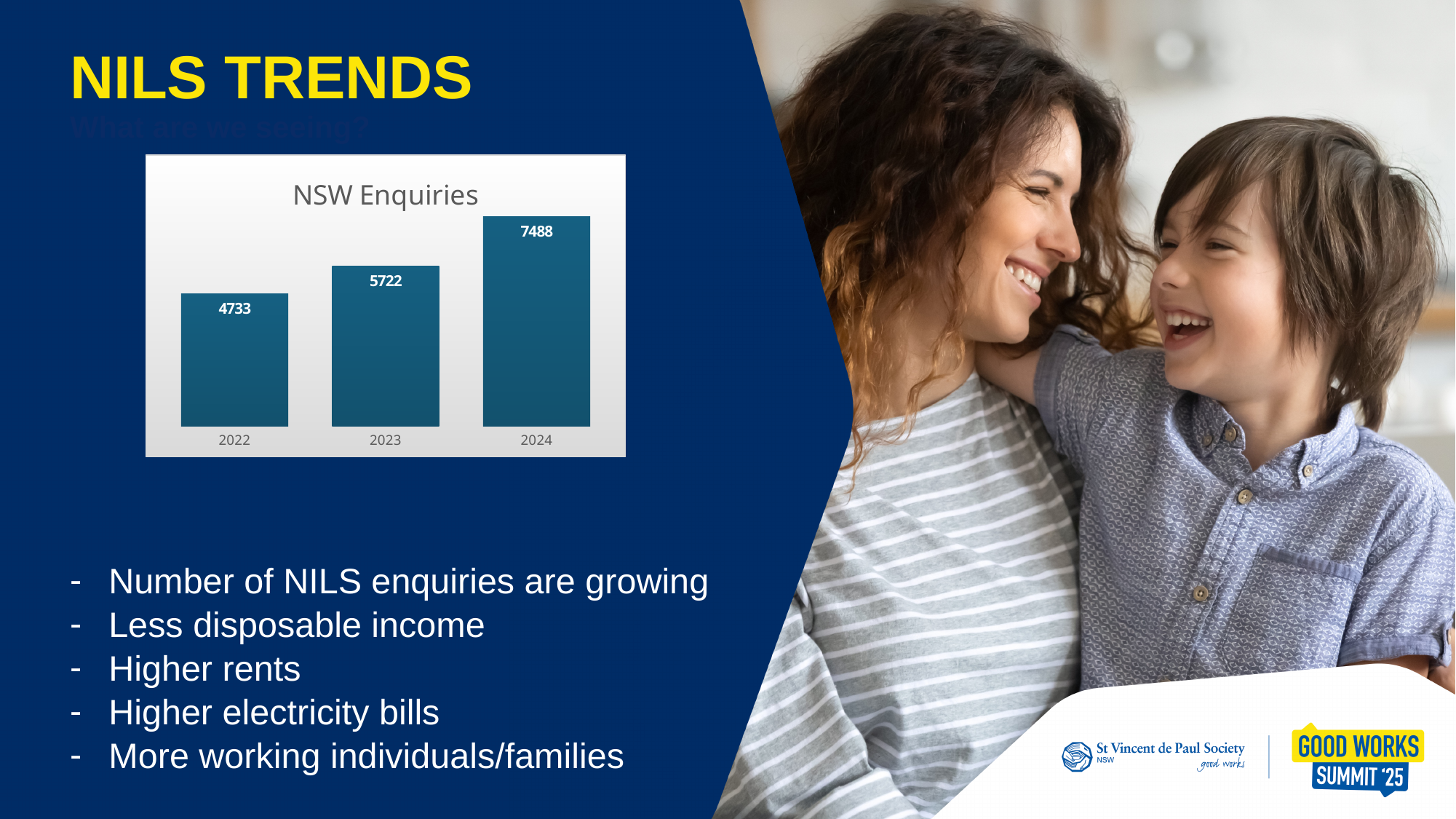
Which year has the highest number of NSW enquiries? 2024 What is the value for 2022 in the NSW Enquiries chart? 4733 Which is larger in the NSW Enquiries chart, the value for 2023 or the value for 2024? 2024 What is the difference between the 2023 and 2022 values in the NSW Enquiries chart? 989 How many years are shown in the NSW Enquiries chart? 3 What kind of chart is the NSW Enquiries chart? Bar chart What is the title of the chart on the slide? NSW Enquiries What is the difference between the 2024 and 2022 values in the NSW Enquiries chart? 2755 Which year has the lowest number of NSW enquiries? 2022 What is the value for 2023 in the NSW Enquiries chart? 5722 What is the value for 2024 in the NSW Enquiries chart? 7488 Do the values in the NSW Enquiries chart rise or fall from 2022 to 2024? Rise